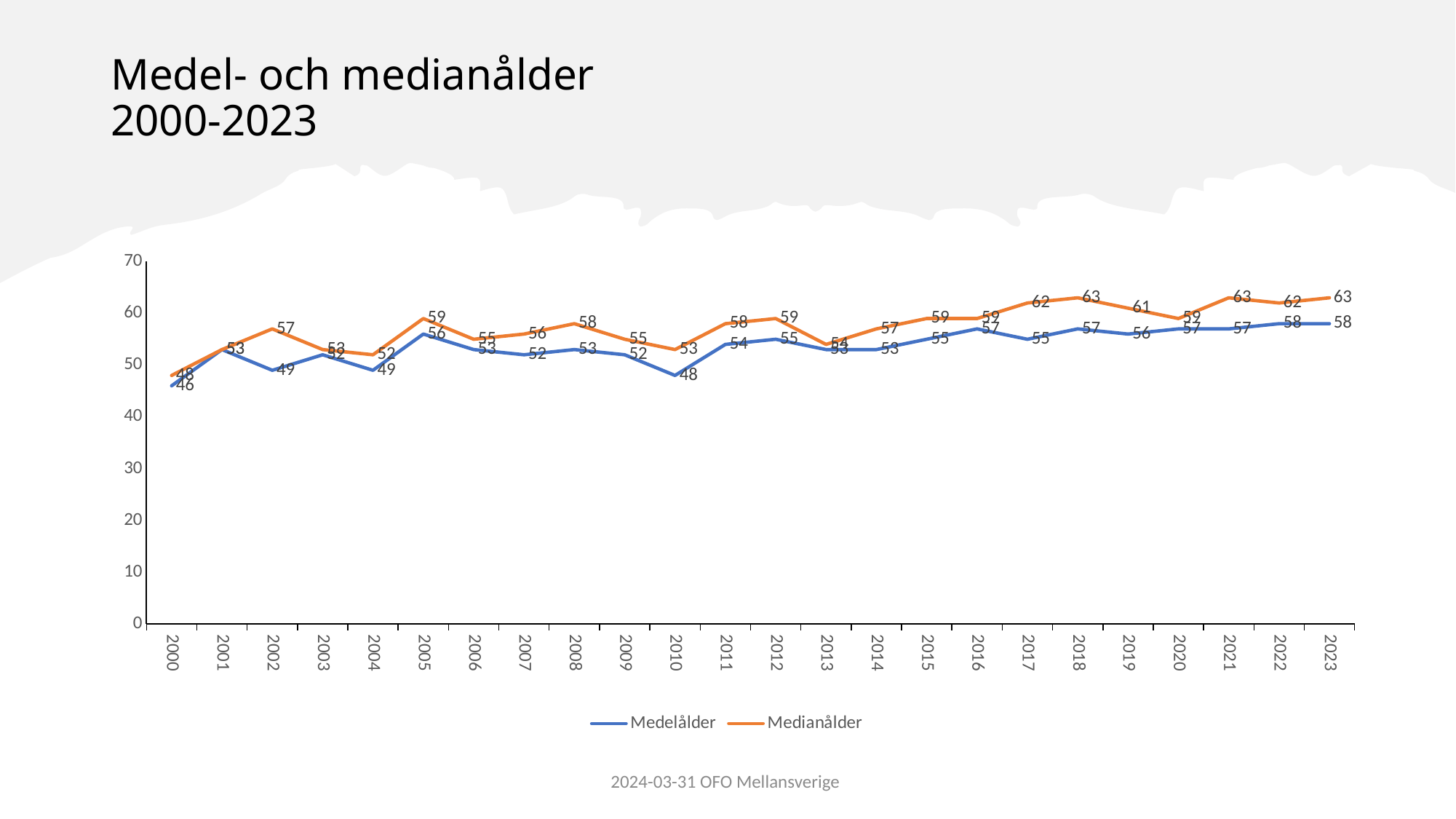
What is the Medianålder value for 2018? 63 How many series does the legend list? 2 What is the difference between Medianålder and Medelålder in 2023? 5 What is the Medelålder value for 2010? 48 In which year is Medelålder at its lowest? 2000 Overall, do the Medianålder values rise or fall from 2000 to 2023? rise In which year is Medianålder at its lowest? 2000 How many years are plotted along the x axis? 24 In 2010, which is larger: Medelålder or Medianålder? Medianålder Is the Medelålder value for 2000 greater or less than 50? less What type of chart is shown on the slide? line chart What is the Medelålder value for 2023? 58